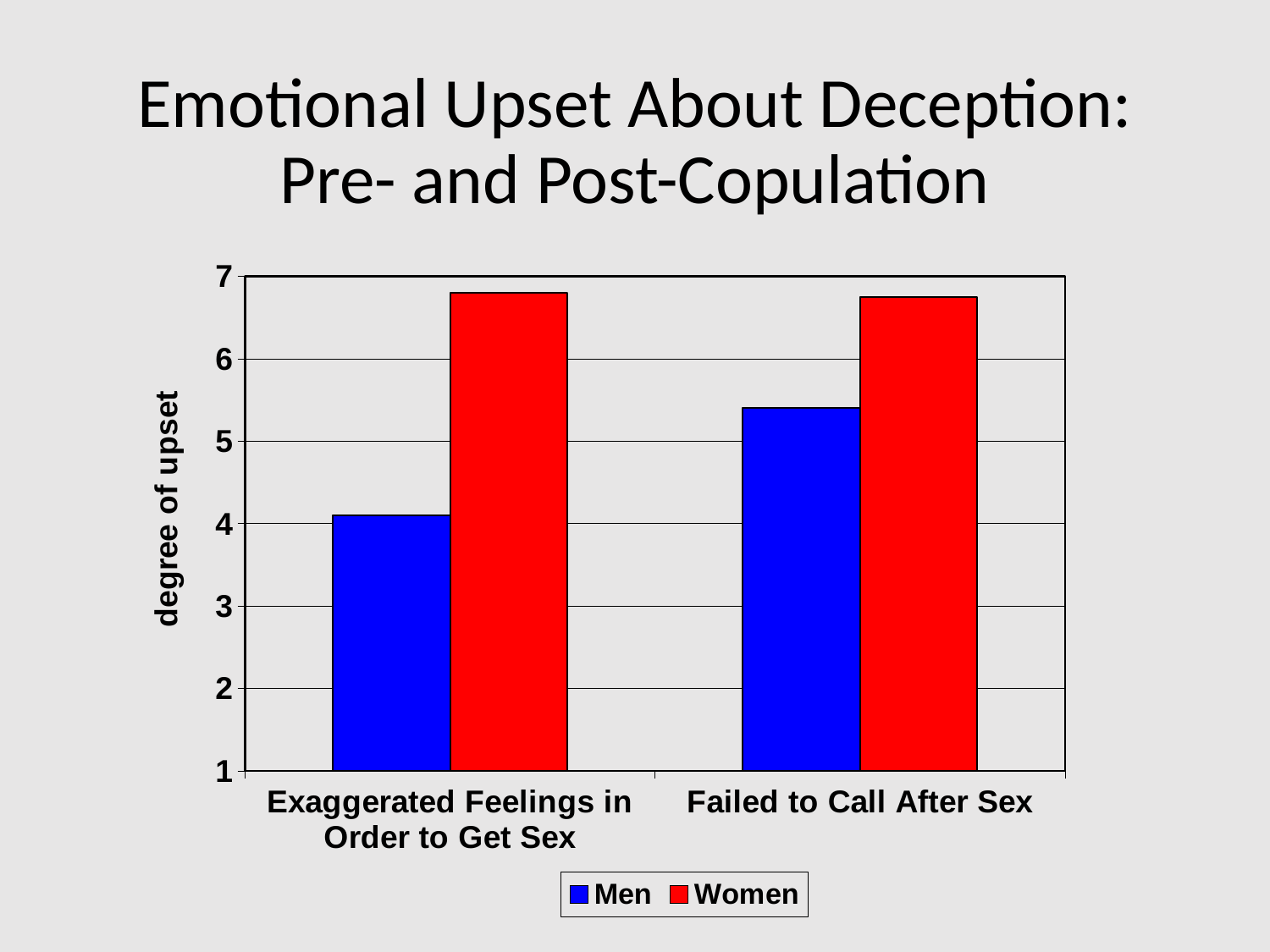
Which is larger for the 'Exaggerated Feelings in Order to Get Sex' category, the value for Men or the value for Women? Women What is the label of the y axis? degree of upset Is the value for Men in the 'Failed to Call After Sex' category greater or less than 6? less Is the value for Men in the 'Failed to Call After Sex' category greater or less than 5? greater Is the value for Women in the 'Failed to Call After Sex' category greater or less than 6? greater How many categories are shown on the x axis? 2 How many series does the legend list? 2 What kind of chart is shown on the slide? bar chart Which is larger for Men, the value for 'Exaggerated Feelings in Order to Get Sex' or the value for 'Failed to Call After Sex'? Failed to Call After Sex Which category has the lowest value for Men? Exaggerated Feelings in Order to Get Sex